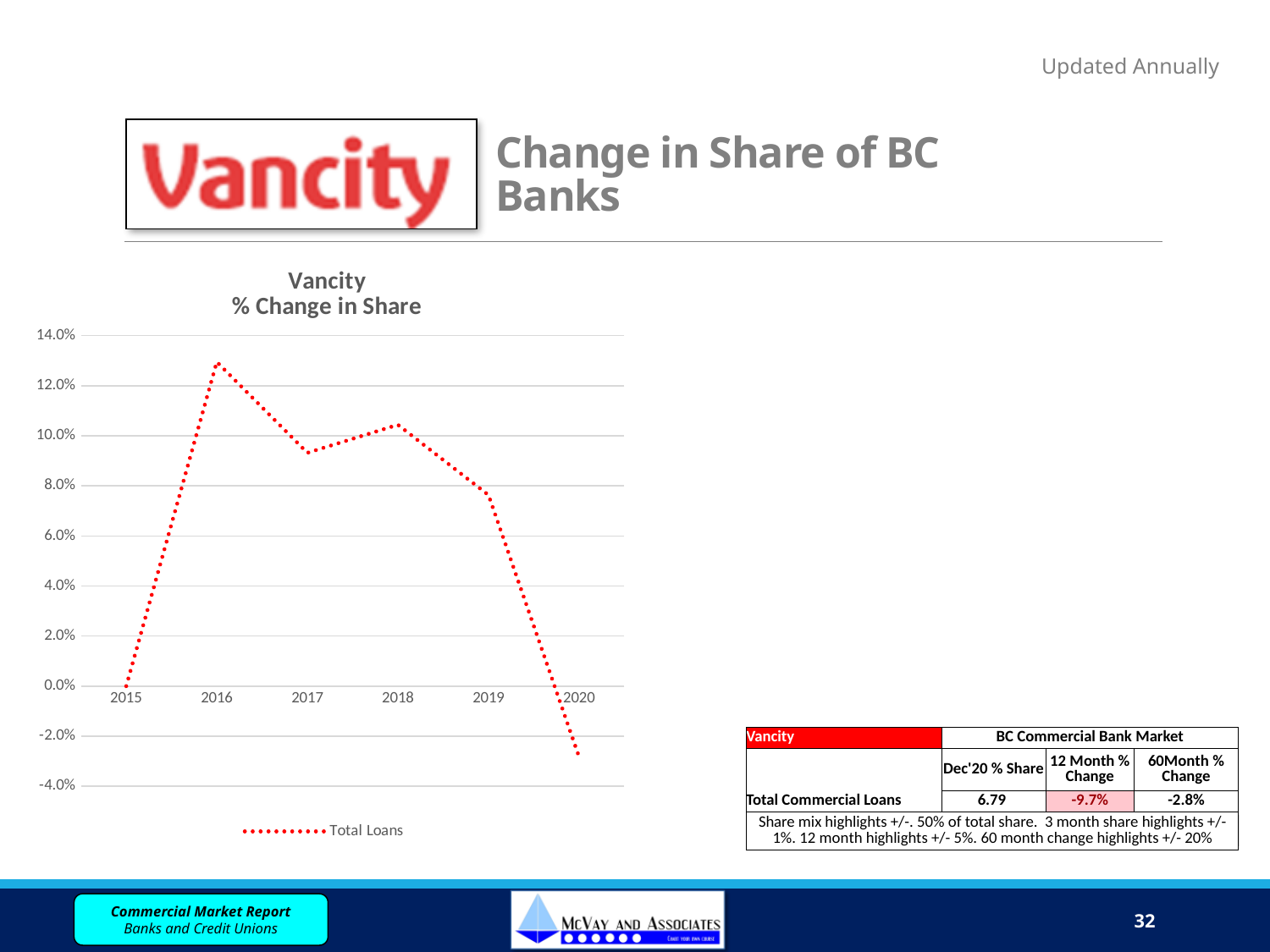
In which year is the % change in share lowest? 2020 How many years are plotted on the x axis of the Vancity % Change in Share chart? 6 Which year has the larger % change in share, 2016 or 2018? 2016 What is the name of the series shown in the chart legend? Total Loans Is the value for 2016 greater or less than 12.0%? greater How many series does the legend of the chart list? 1 Is the value for 2019 greater or less than 6.0%? greater Do the values rise or fall from 2018 to 2020? fall What kind of chart is shown on the slide? line chart Is the value for 2020 greater or less than 0.0%? less In which year is the % change in share highest? 2016